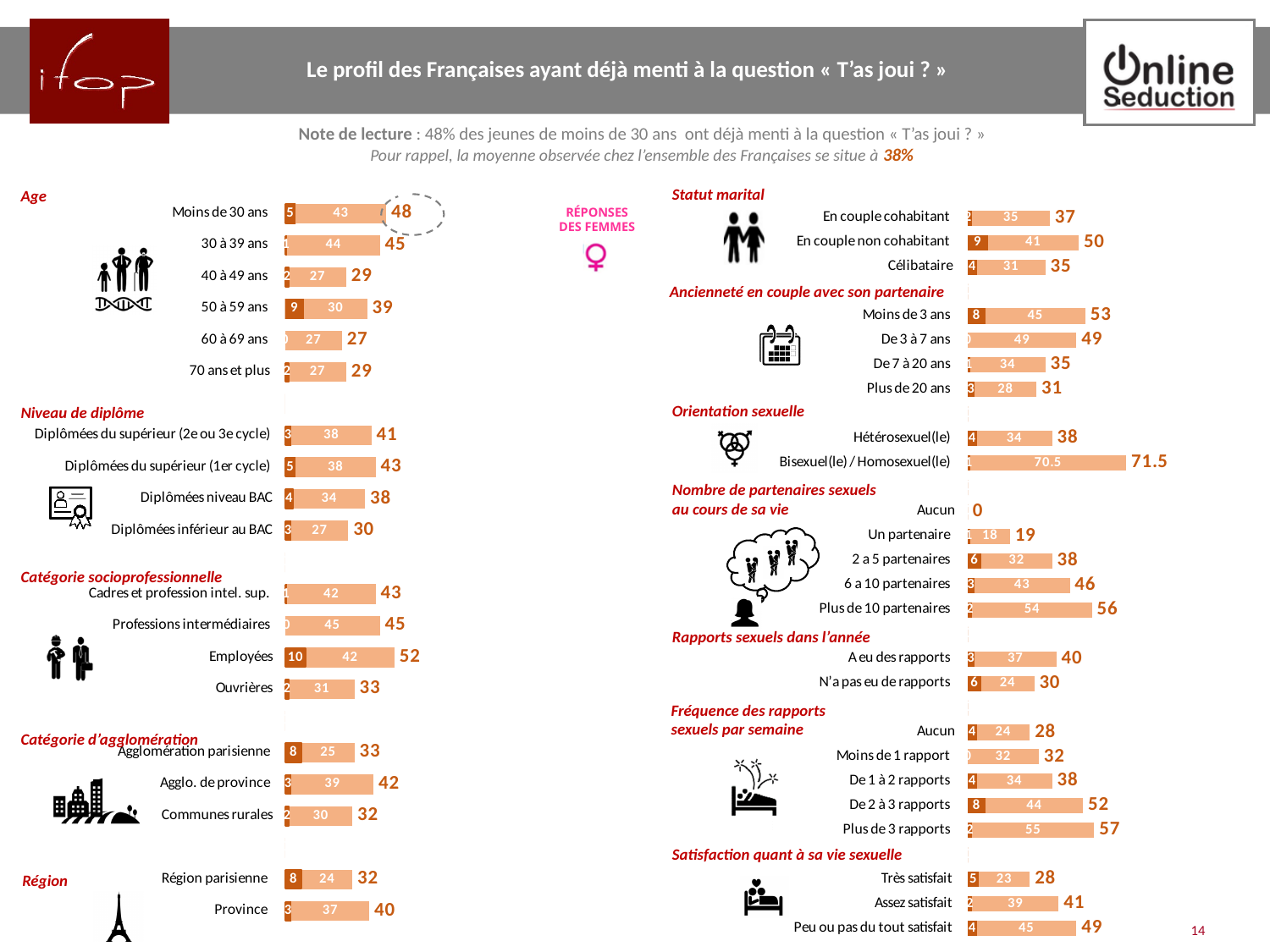
In the 'Orientation sexuelle' chart, what is the total value for 'Bisexuel(le) / Homosexuel(le)'? 71.5 In the 'Catégorie socioprofessionnelle' chart, which category has the highest total value? Employées In the 'Age' chart, which age group has the lowest total value? 60 à 69 ans In the 'Age' chart, what is the total value for 'Moins de 30 ans'? 48 In the 'Ancienneté en couple avec son partenaire' chart, do the total values rise or fall as the relationship length increases from 'Moins de 3 ans' to 'Plus de 20 ans'? fall In the 'Catégorie socioprofessionnelle' chart, what is the difference between the totals for 'Employées' and 'Ouvrières'? 19 In the 'Nombre de partenaires sexuels au cours de sa vie' chart, how many categories are shown? 5 In the 'Région' chart, what is the difference between the totals for 'Province' and 'Région parisienne'? 8 In the 'Fréquence des rapports sexuels par semaine' chart, which category has the highest total value? Plus de 3 rapports What type of chart is used for the 'Satisfaction quant à sa vie sexuelle' section? Stacked bar chart In the 'Statut marital' chart, which is larger: the total for 'En couple non cohabitant' or 'Célibataire'? En couple non cohabitant In the 'Nombre de partenaires sexuels au cours de sa vie' chart, what is the total value for 'Plus de 10 partenaires'? 56